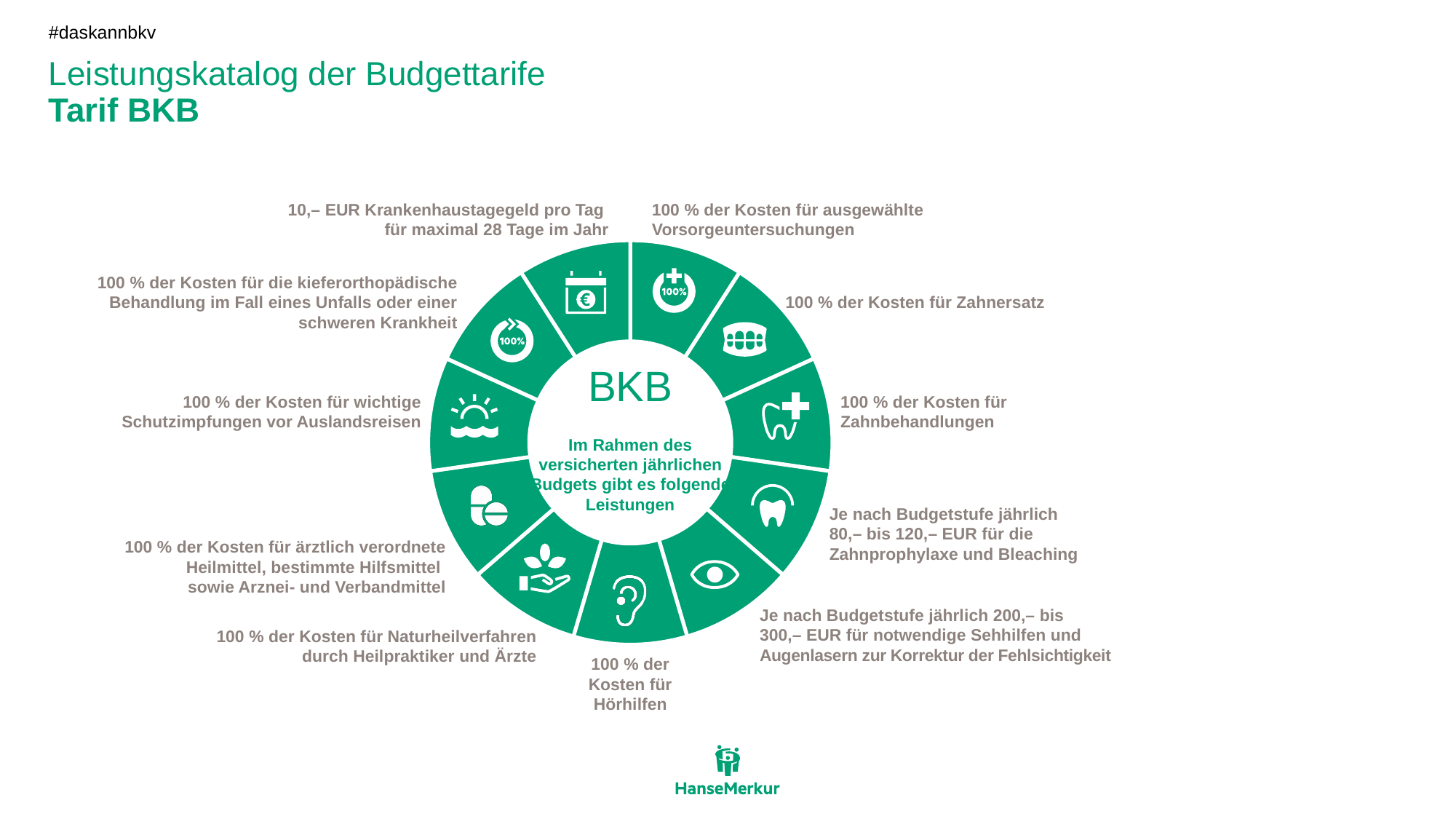
What label is shown in the centre of the ring diagram? BKB How many segments does the ring diagram contain? 11 What annual amount range is given for Zahnprophylaxe und Bleaching? 80,– bis 120,– EUR What kind of chart is shown on the slide? A donut (ring) diagram with icon segments Which is larger: the upper limit for Sehhilfen or the upper limit for Zahnprophylaxe? Sehhilfen (300,– EUR) What is the title of the slide? Leistungskatalog der Budgettarife – Tarif BKB What daily amount of Krankenhaustagegeld is listed in the diagram? 10,– EUR What percentage of the costs for Zahnersatz is covered according to the diagram? 100 % What is the difference between the upper and lower annual limits for Zahnprophylaxe und Bleaching? 40,– EUR What annual amount range is given for Sehhilfen und Augenlasern? 200,– bis 300,– EUR What percentage of the costs for Hörhilfen is covered according to the diagram? 100 % For how many days per year at most is the Krankenhaustagegeld paid? 28 Tage